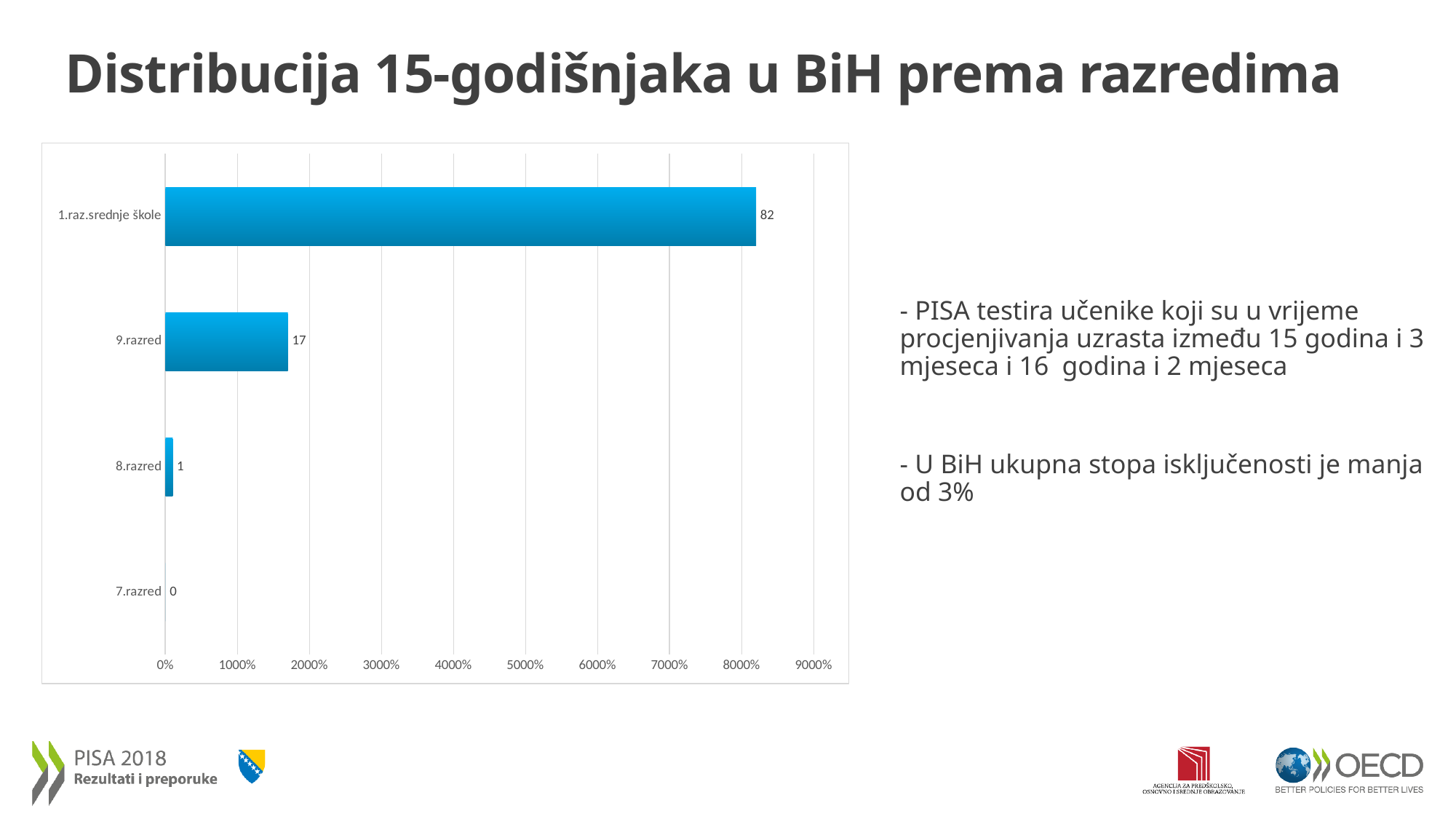
Which category has the lowest value? 7.razred Which is larger, the value for 9.razred or the value for 8.razred? 9.razred How many categories are shown in the chart? 4 What is the value for 9.razred? 17 What is the total of the values for 9.razred and 8.razred? 18 What is the value for 1.raz.srednje škole? 82 What kind of chart is shown on the slide? bar chart What is the value for 7.razred? 0 What is the difference between the values for 1.raz.srednje škole and 9.razred? 65 What is the value for 8.razred? 1 Which category has the highest value? 1.raz.srednje škole What is the title of the slide containing the chart? Distribucija 15-godišnjaka u BiH prema razredima